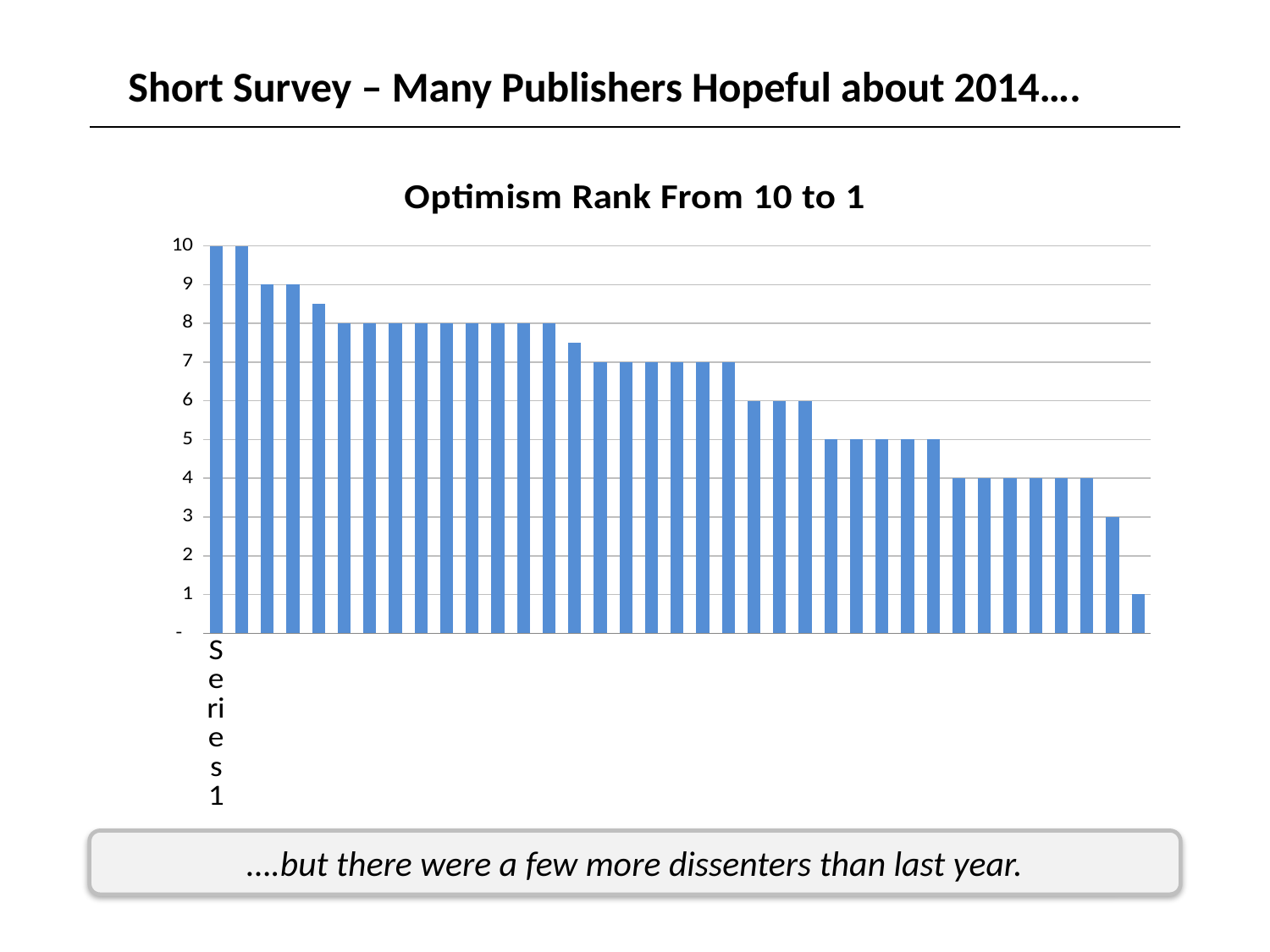
What is the value of the second-to-last bar? 3 What is the value of the first (leftmost) bar? 10 Do the bar values rise or fall moving from left to right along the x axis? fall How many bars reach the value 10? 2 What is the difference between the first bar and the last bar? 9 What is the value of the last (rightmost) bar? 1 What kind of chart is shown on the slide? bar chart What is the title of the chart? Optimism Rank From 10 to 1 Is the value of the fifth bar from the left greater or less than 8? greater What is the highest value reached by any bar in the chart? 10 Which is larger, the first bar or the last bar? the first bar What is the lowest value reached by any bar in the chart? 1